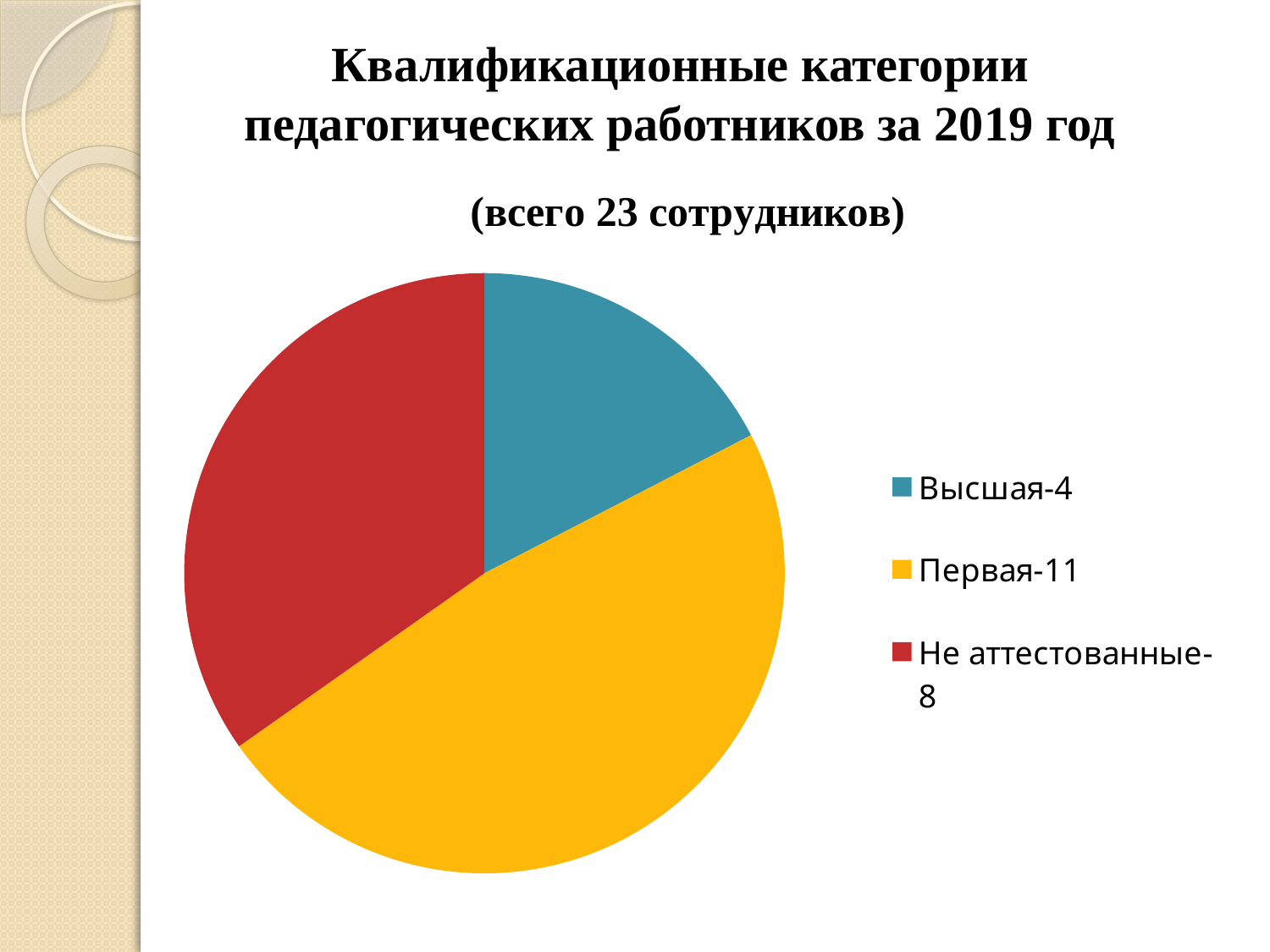
What is the difference between the values for Первая and Не аттестованные? 3 What is the value for the category Первая? 11 Which category has the largest slice of the pie? Первая Which category has the smallest slice of the pie? Высшая Which is larger, the value for Не аттестованные or the value for Высшая? Не аттестованные What is the value for the category Не аттестованные? 8 What is the total number of employees represented in the pie chart? 23 What kind of chart is shown on the slide? pie chart What is the value for the category Высшая? 4 What is the difference between the values for Не аттестованные and Высшая? 4 How many categories does the pie chart have? 3 What colour is the slice for Первая? yellow